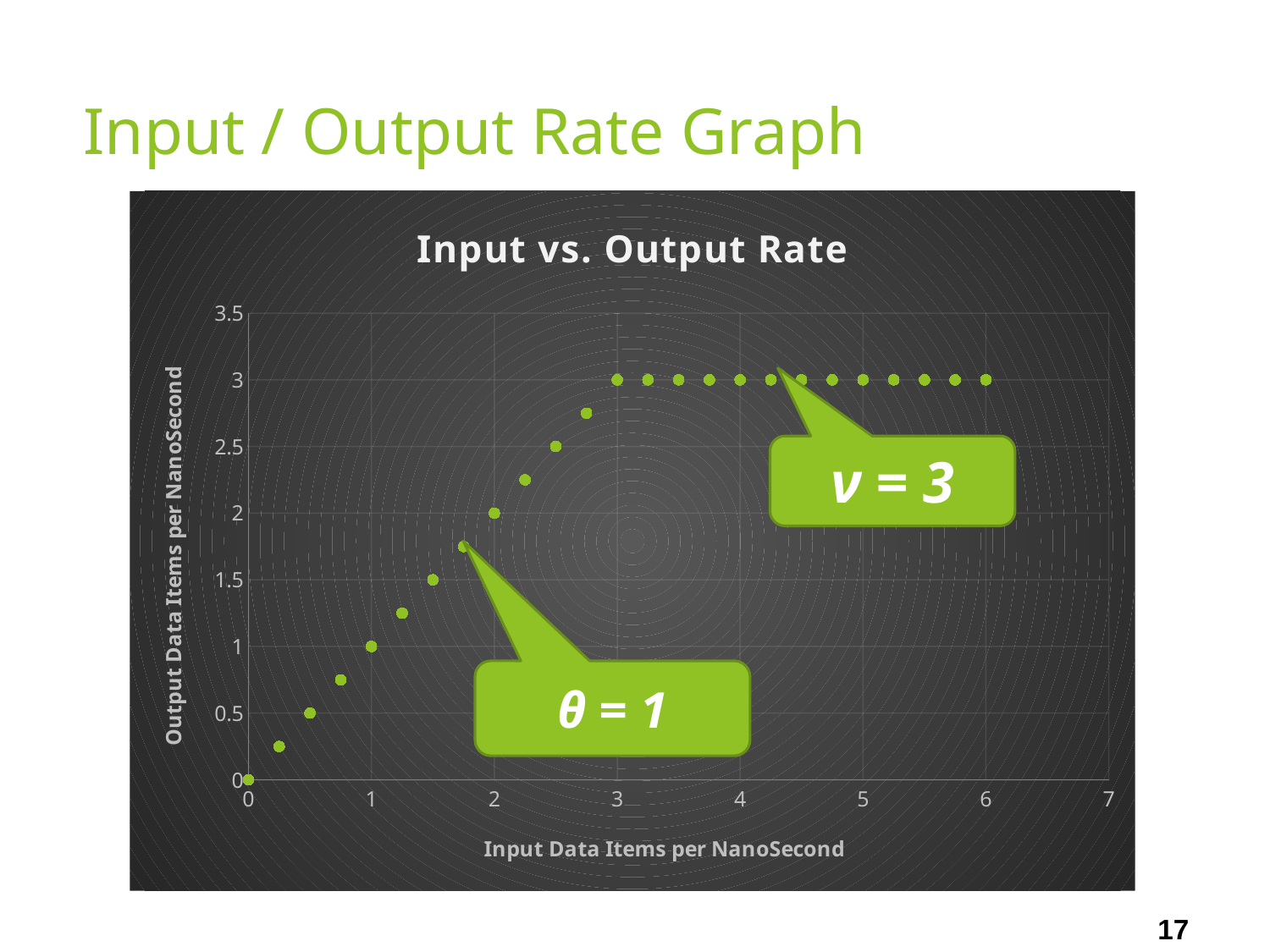
What is the label of the y axis? Output Data Items per NanoSecond What is the title of the chart? Input vs. Output Rate What is the lowest output rate plotted on the chart? 0 Is the output rate at an input rate of 0.5 greater or less than 1? less Is the output rate at an input rate of 2.5 greater or less than 2? greater Which is larger, the output rate at an input rate of 1 or at an input rate of 4? input rate of 4 What is the highest output rate reached on the chart? 3 What kind of chart is shown on the slide? scatter chart How does the output rate change as the input rate increases from 0 to 6? It rises steadily until the input rate reaches 3, then stays flat at 3 What is the output rate when the input rate is 1? 1 What is the output rate when the input rate is 6? 3 What is the output rate when the input rate is 2? 2